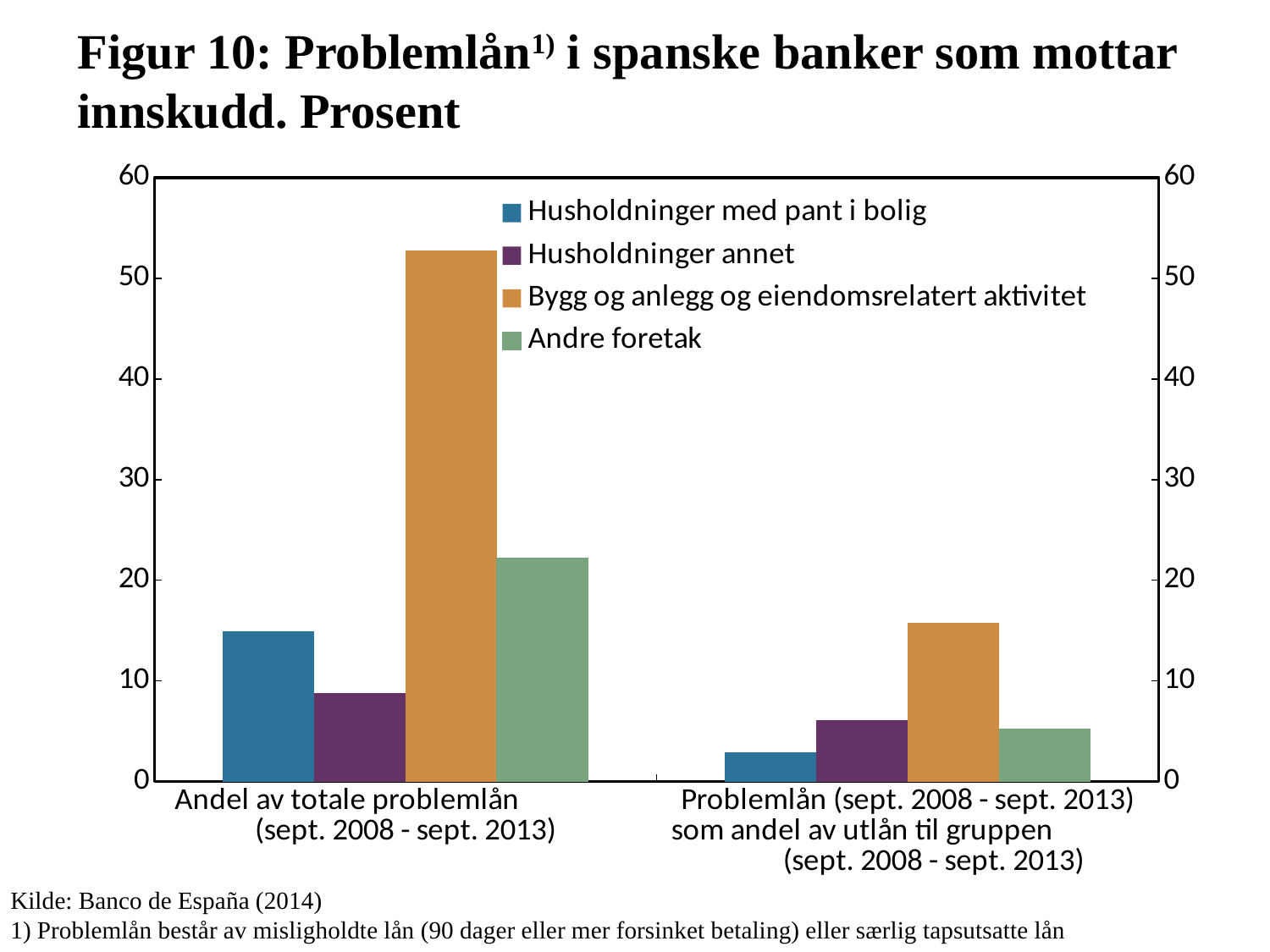
How many series does the legend list? 4 Which series has the lowest value in the 'Andel av totale problemlån (sept. 2008 - sept. 2013)' group? Husholdninger annet What kind of chart is shown on the slide? bar chart Is the value for 'Husholdninger med pant i bolig' in the 'Andel av totale problemlån' group greater or less than 20? less Which series has the highest value in the 'Andel av totale problemlån (sept. 2008 - sept. 2013)' group? Bygg og anlegg og eiendomsrelatert aktivitet Is the value for 'Andre foretak' in the 'Andel av totale problemlån' group greater or less than 20? greater Which series has the lowest value in the 'Problemlån (sept. 2008 - sept. 2013) som andel av utlån til gruppen' group? Husholdninger med pant i bolig Is the value for 'Bygg og anlegg og eiendomsrelatert aktivitet' in the 'Problemlån som andel av utlån til gruppen' group greater or less than 10? greater How many category groups are shown on the x axis? 2 In the 'Andel av totale problemlån' group, which is larger: 'Husholdninger med pant i bolig' or 'Husholdninger annet'? Husholdninger med pant i bolig What is the source cited below the chart? Banco de España (2014)